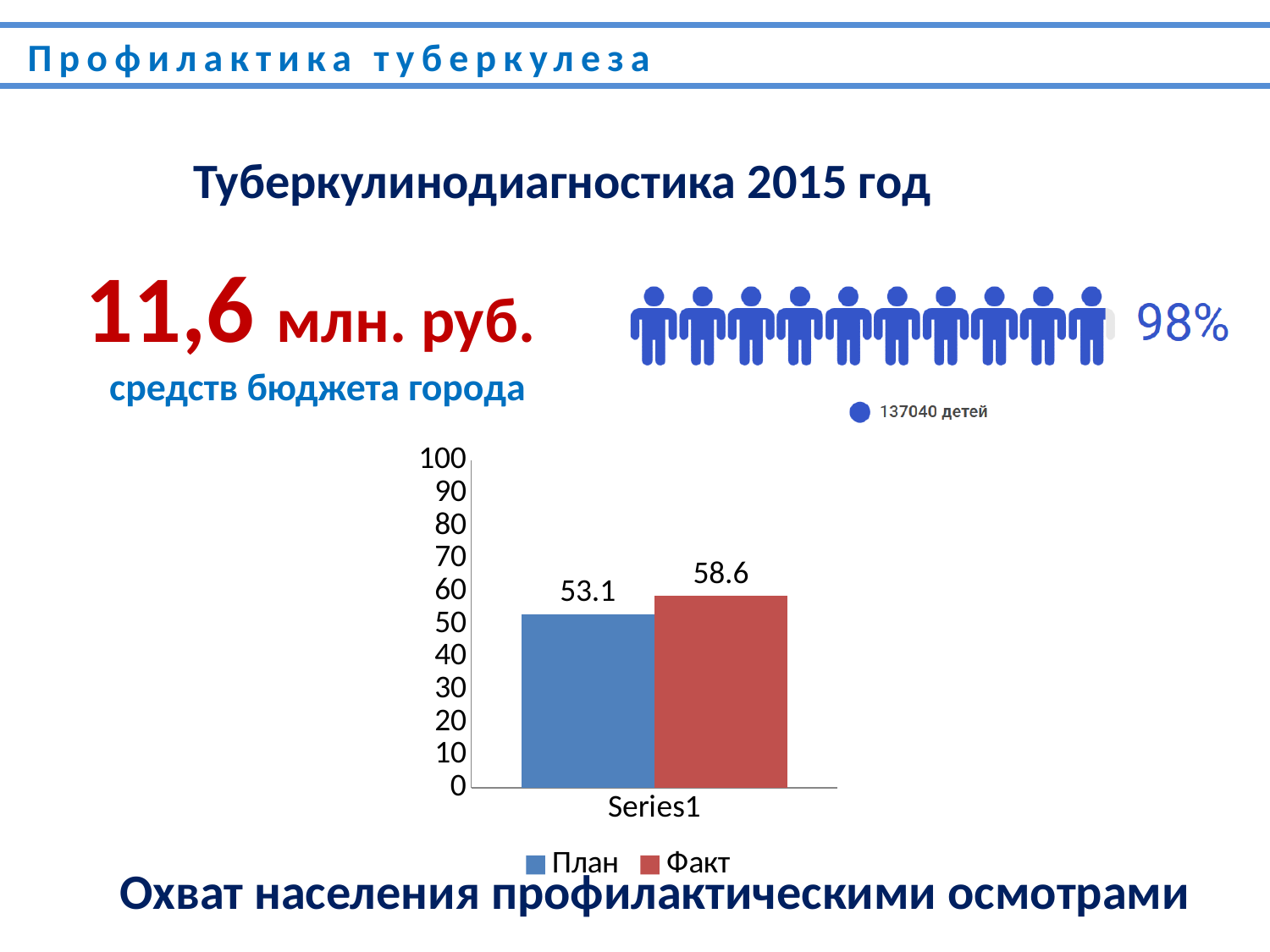
Which series has the lowest value in the bar chart? План What is the value of the Факт bar in the bar chart? 58.6 Which series has the higher value in the bar chart, План or Факт? Факт How many series does the legend of the bar chart list? 2 How many bars are plotted in the bar chart? 2 What is the difference between the Факт and План values in the bar chart? 5.5 What is the category label shown on the horizontal axis of the bar chart? Series1 What type of chart is shown on the slide? bar chart What is the value of the План bar in the bar chart? 53.1 What is the maximum value shown on the vertical axis of the bar chart? 100 Is the value of the План bar greater or less than 60? less Is the value of the Факт bar greater or less than 50? greater